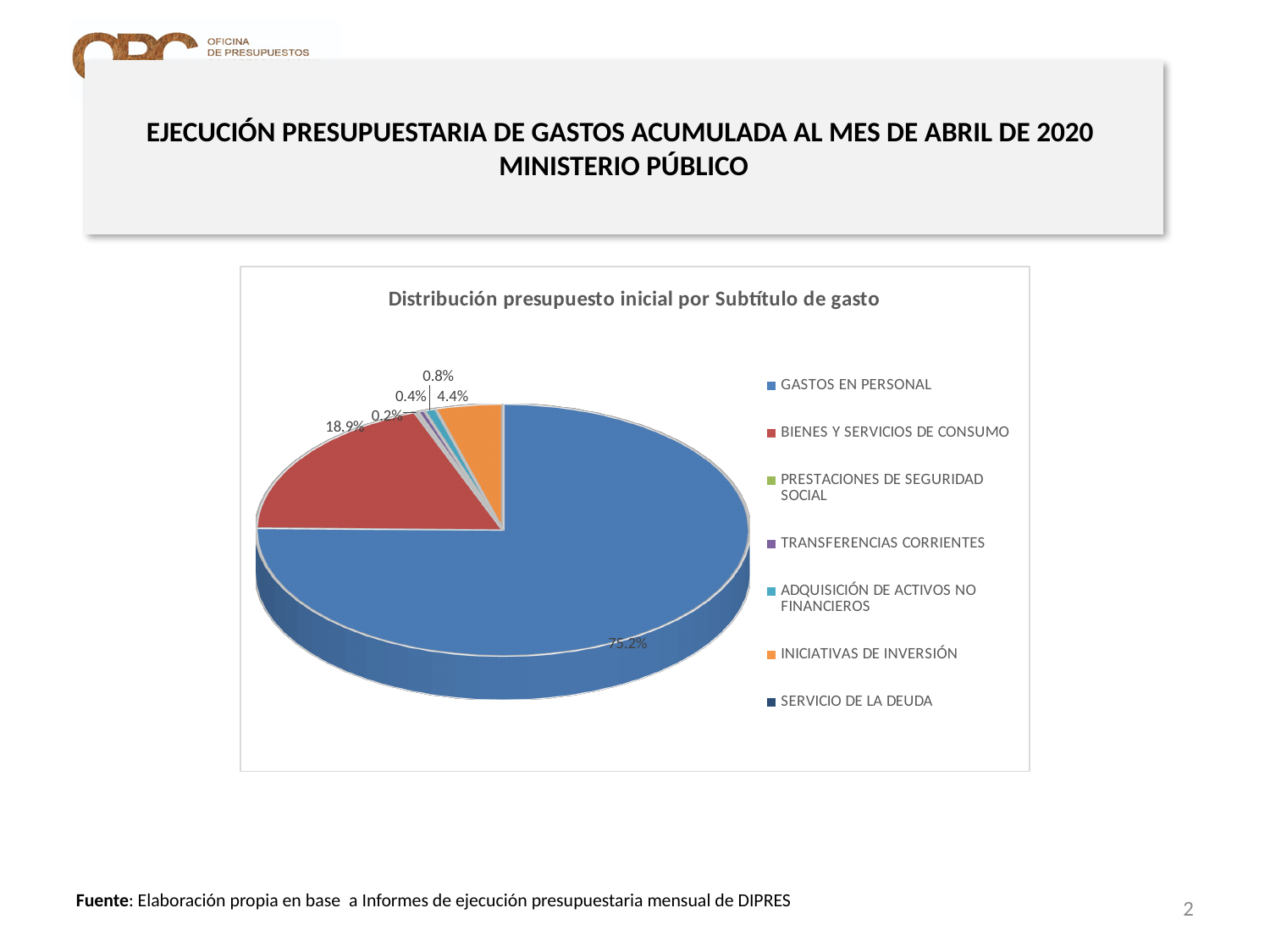
Which is larger, the share for BIENES Y SERVICIOS DE CONSUMO or the share for INICIATIVAS DE INVERSIÓN? BIENES Y SERVICIOS DE CONSUMO What share of the initial budget does GASTOS EN PERSONAL represent? 75.2% What colour is the slice for GASTOS EN PERSONAL? blue What percentage is shown for BIENES Y SERVICIOS DE CONSUMO? 18.9% What percentage is shown for INICIATIVAS DE INVERSIÓN? 4.4% What kind of chart is shown on the slide? pie chart What is the title of the chart? Distribución presupuesto inicial por Subtítulo de gasto What percentage is shown for ADQUISICIÓN DE ACTIVOS NO FINANCIEROS? 0.8% What is the difference in percentage points between BIENES Y SERVICIOS DE CONSUMO and INICIATIVAS DE INVERSIÓN? 14.5 percentage points How many categories does the legend list? 7 What is the difference in percentage points between GASTOS EN PERSONAL and BIENES Y SERVICIOS DE CONSUMO? 56.3 percentage points Which category has the largest slice of the pie? GASTOS EN PERSONAL